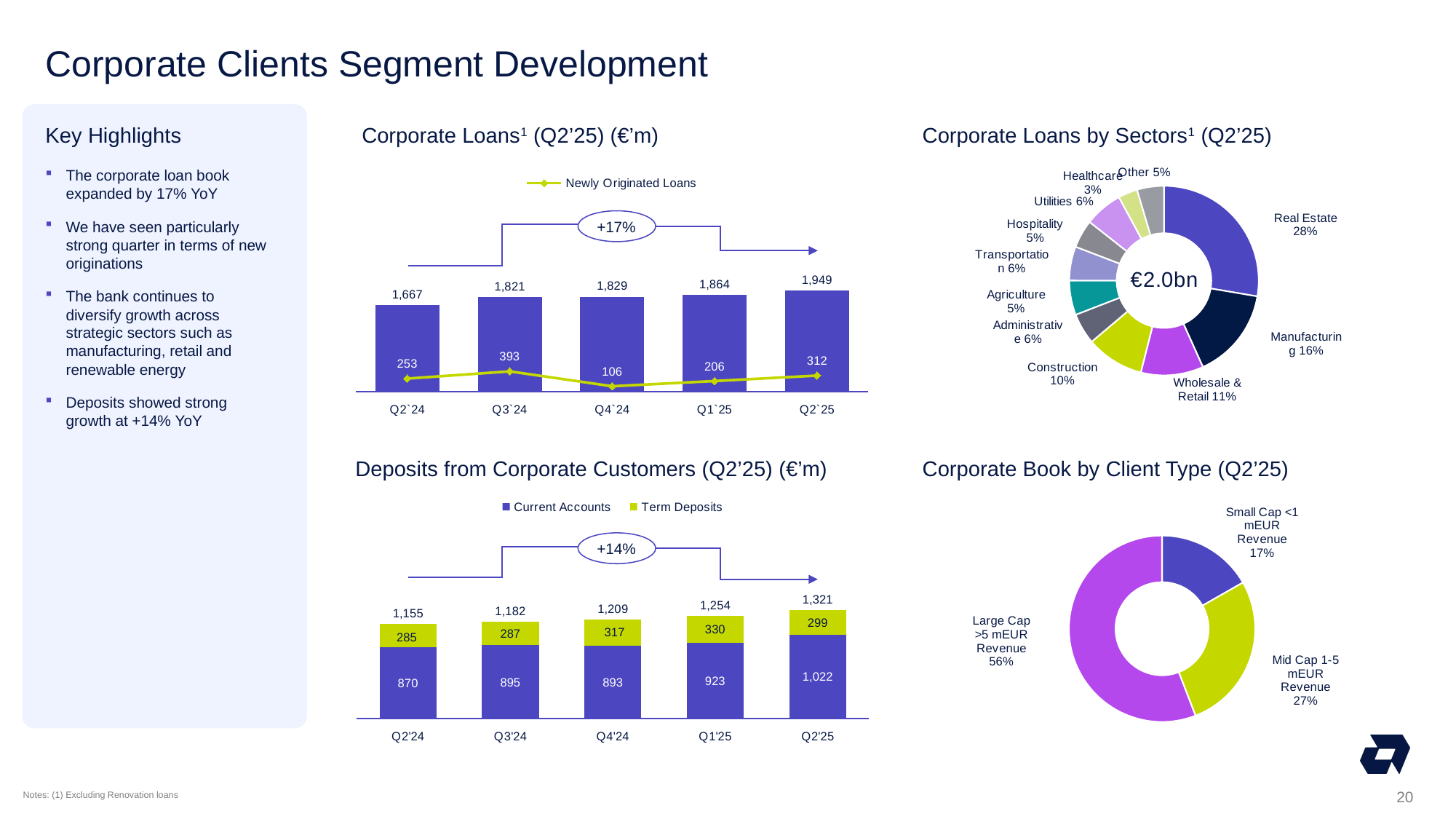
In the Corporate Loans (Q2'25) chart, what is the Newly Originated Loans value for Q4`24? 106 In the Corporate Loans by Sectors (Q2'25) chart, what total amount is shown in the centre of the donut? €2.0bn In the Corporate Loans (Q2'25) chart, what is the value of the bar for Q2`25? 1,949 In the Corporate Loans (Q2'25) chart, which quarter has the highest Newly Originated Loans value? Q3`24 In the Deposits from Corporate Customers (Q2'25) chart, what is the Term Deposits value for Q1'25? 330 In the Corporate Loans by Sectors (Q2'25) chart, which sector has the smallest share? Healthcare In the Corporate Book by Client Type (Q2'25) chart, what share does Mid Cap 1-5 mEUR Revenue have? 27% In the Corporate Loans by Sectors (Q2'25) chart, what share does Real Estate have? 28% In the Corporate Loans (Q2'25) chart, what is the difference between the Q2`25 bar and the Q2`24 bar? 282 In the Deposits from Corporate Customers (Q2'25) chart, what is the total of the stacked bar for Q2'25? 1,321 In the Corporate Loans (Q2'25) chart, do the bar values rise or fall from Q2`24 to Q2`25? rise How many series does the legend of the Deposits from Corporate Customers (Q2'25) chart list? 2